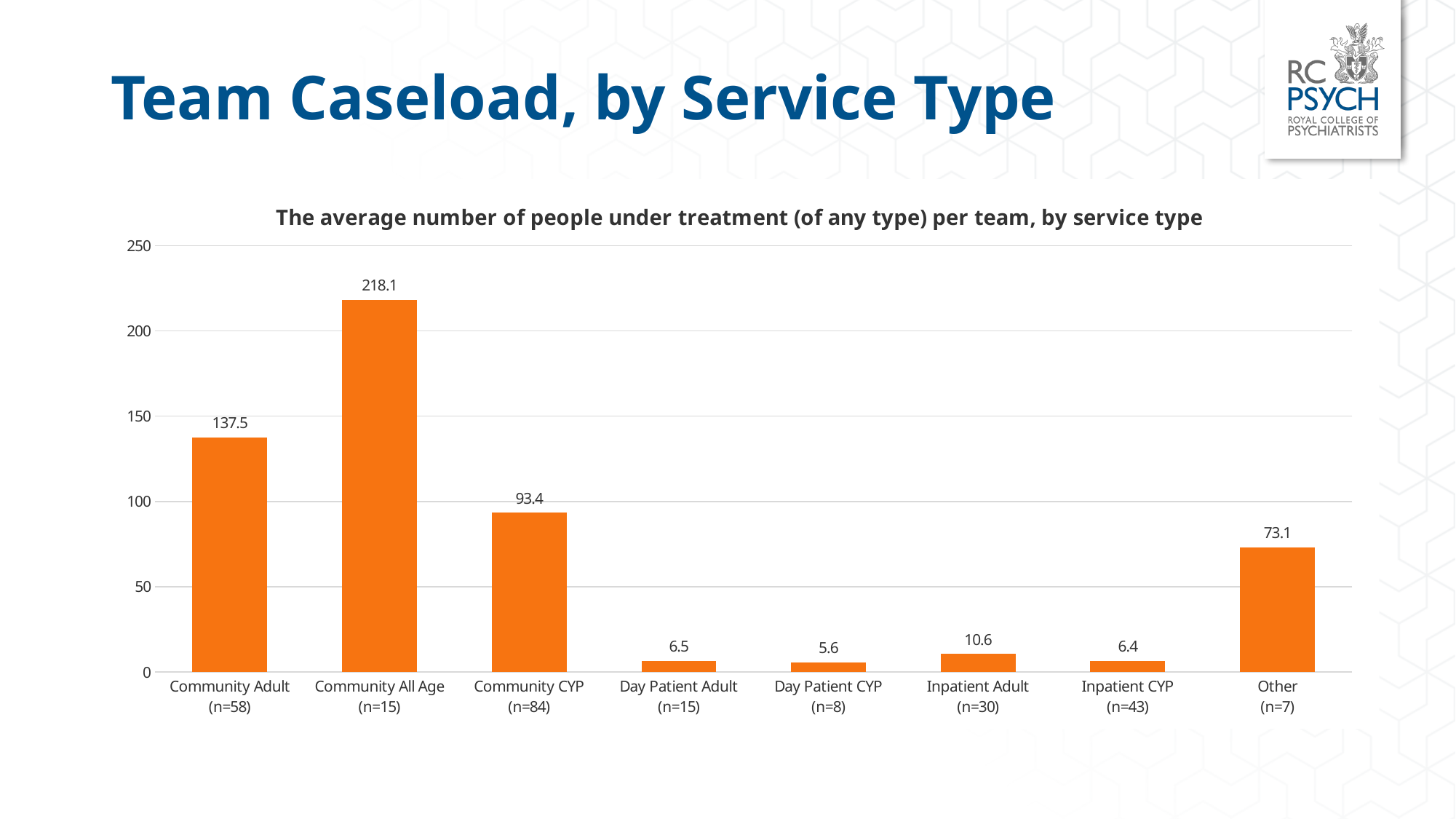
What is the title of the chart? The average number of people under treatment (of any type) per team, by service type How many service types are shown on the chart? 8 What is the difference between the values for Community CYP and Other? 20.3 What is the value shown for Other? 73.1 Which service type has the highest average caseload per team? Community All Age What is the value shown for Inpatient Adult? 10.6 Which is larger, the value for Day Patient Adult or the value for Inpatient CYP? Day Patient Adult Which service type has the lowest average caseload per team? Day Patient CYP What kind of chart is shown on the slide? Bar chart What is the difference between the values for Community All Age and Community Adult? 80.6 What is the average number of people under treatment per team for Community Adult? 137.5 Is the value for Community CYP greater or less than 100? less